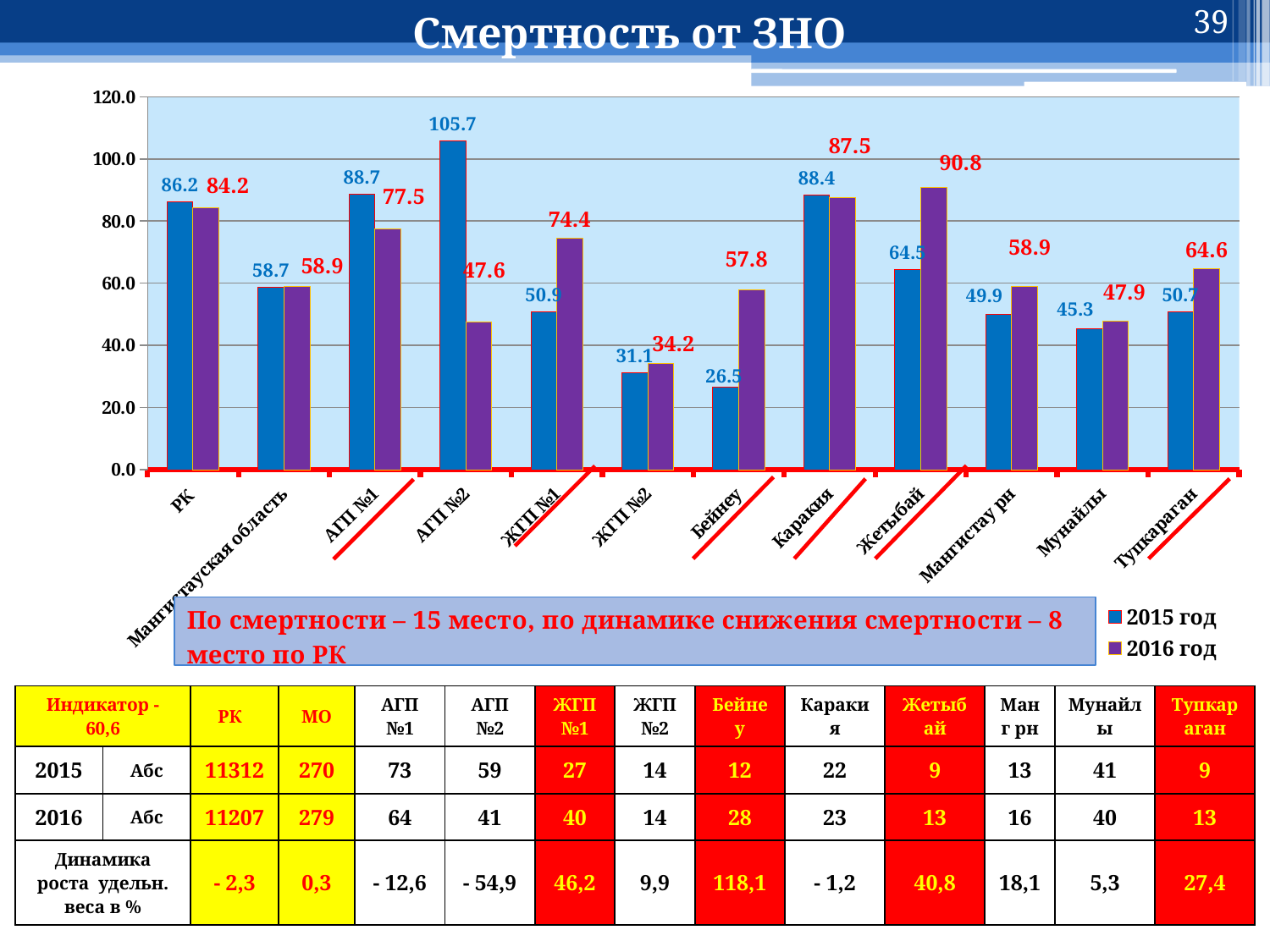
What is the title of the chart on the slide? Смертность от ЗНО Which category has the highest 2016 год value? Жетыбай What type of chart is shown on the slide? Bar chart How many categories are shown on the x axis of the chart? 12 What is the 2016 год value for Жетыбай? 90.8 Which is larger for ЖГП №1: the 2015 год value or the 2016 год value? 2016 год What is the 2015 год value for АГП №2? 105.7 How many series does the chart legend list? 2 What is the difference between the 2015 год and 2016 год values for АГП №2? 58.1 Which category has the lowest 2016 год value? ЖГП №2 What is the 2015 год value for Бейнеу? 26.5 Which category has the highest 2015 год value? АГП №2